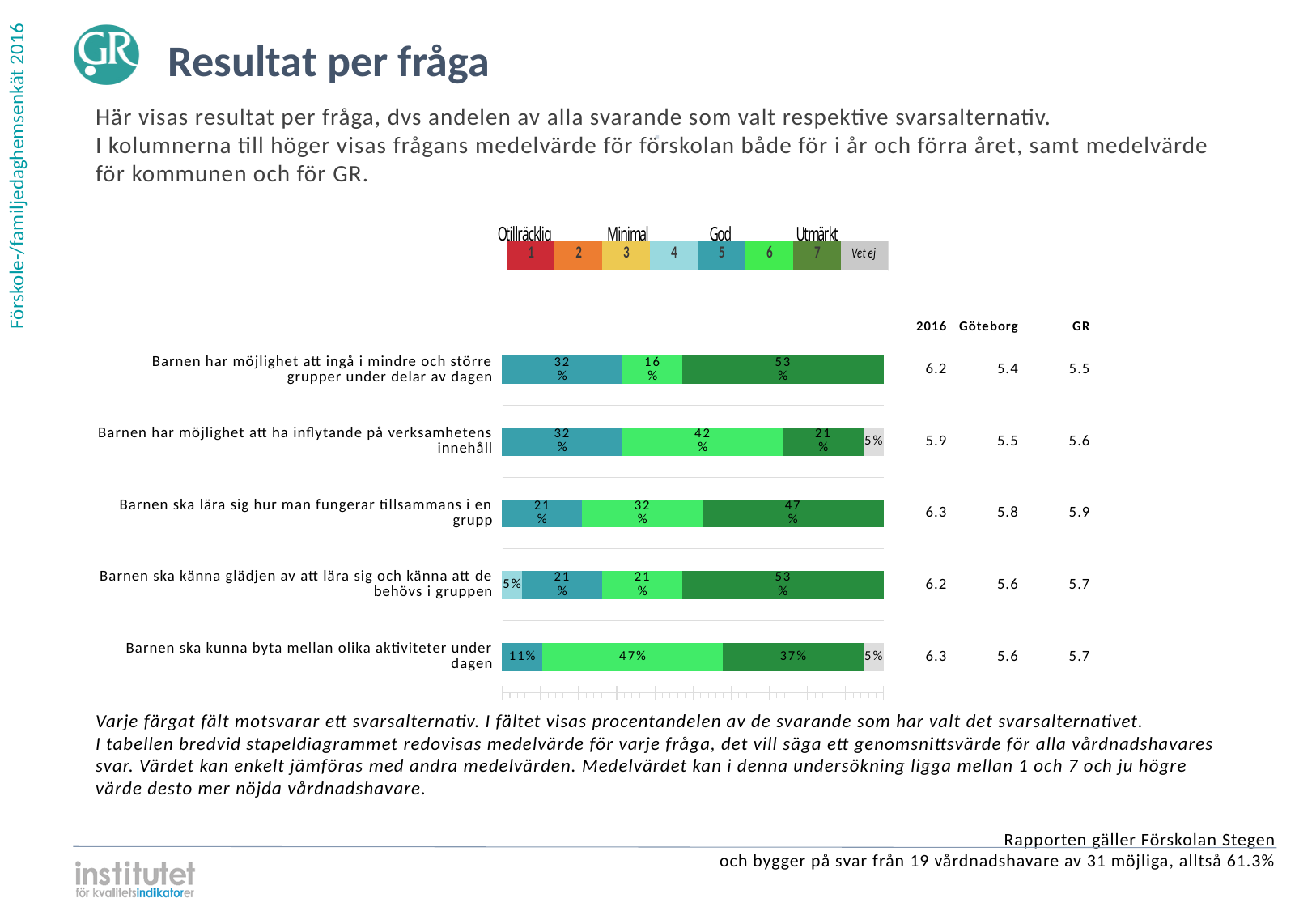
How many answer options does the colour legend above the chart list? 8 What is the combined share of answers 6 and 7 for "Barnen har möjlighet att ingå i mindre och större grupper under delar av dagen"? 69% What percentage of respondents chose answer 7 (dark green) for "Barnen ska lära sig hur man fungerar tillsammans i en grupp"? 47% What is the difference between the 2016 mean and the Göteborg mean for "Barnen har möjlighet att ingå i mindre och större grupper under delar av dagen"? 0.8 For "Barnen ska kunna byta mellan olika aktiviteter under dagen", which is larger: the share for answer 6 or the share for answer 7? Answer 6 (47%) Which question has the lowest 2016 mean value? Barnen har möjlighet att ha inflytande på verksamhetens innehåll What is the GR mean value for "Barnen har möjlighet att ingå i mindre och större grupper under delar av dagen"? 5.5 What is the "Vet ej" share for "Barnen har möjlighet att ha inflytande på verksamhetens innehåll"? 5% What percentage chose answer 6 (light green) for "Barnen ska kunna byta mellan olika aktiviteter under dagen"? 47% What is the 2016 mean value for "Barnen ska känna glädjen av att lära sig och känna att de behövs i gruppen"? 6.2 What kind of chart is used to show the results per question? Stacked bar chart How many questions (bars) are shown in the chart? 5